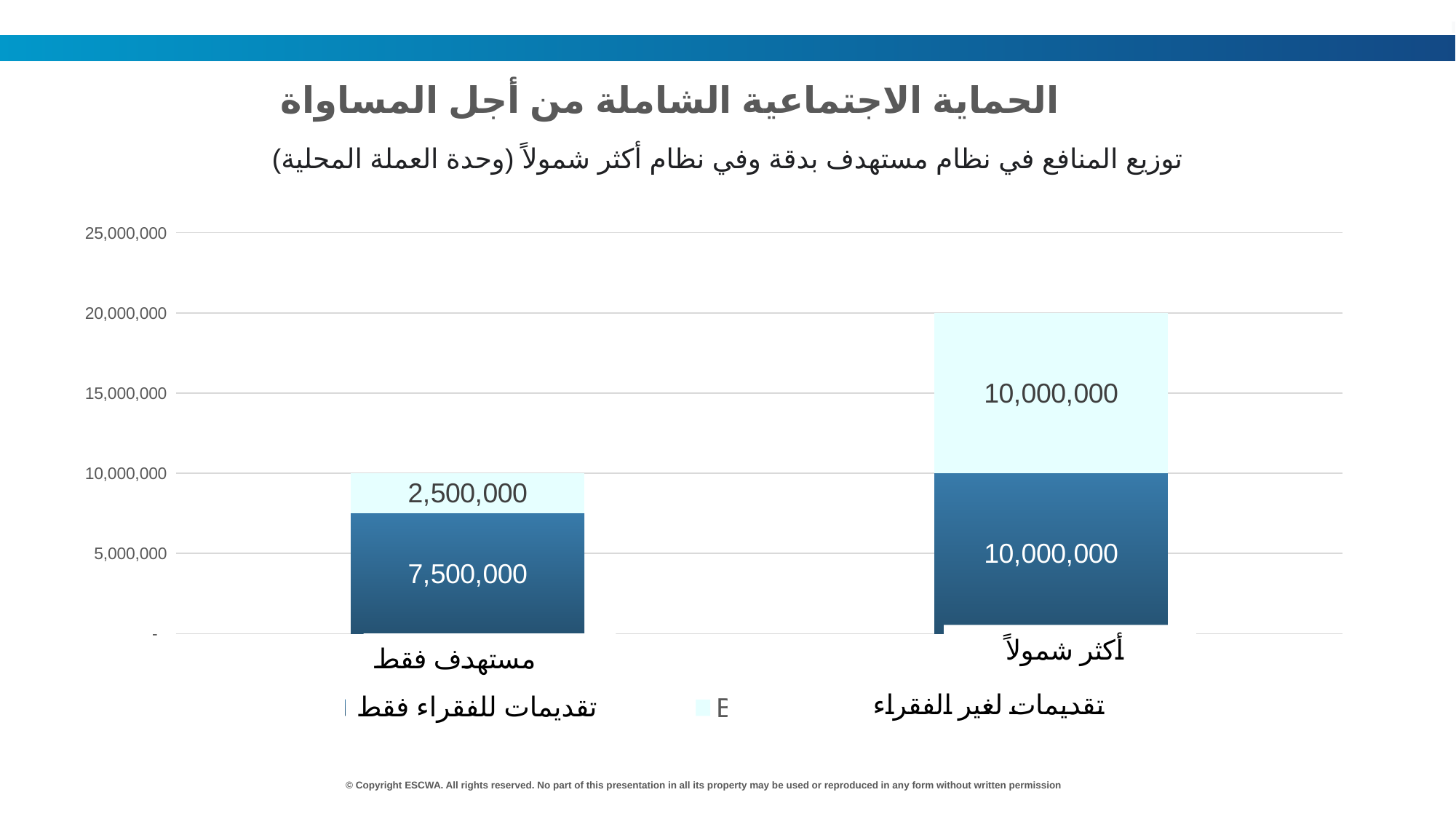
Which category has the higher total stacked bar? أكثر شمولاً What is the total of the stacked bar for مستهدف فقط? 10,000,000 What type of chart is shown on the slide? Stacked bar chart What is the total of the stacked bar for أكثر شمولاً? 20,000,000 What is the value of تقديمات للفقراء فقط for the category مستهدف فقط? 7,500,000 How many categories are shown on the x axis of the chart? 2 What is the value of تقديمات لغير الفقراء for the category أكثر شمولاً? 10,000,000 What is the difference between the تقديمات للفقراء فقط values for أكثر شمولاً and مستهدف فقط? 2,500,000 Is the value of تقديمات لغير الفقراء for مستهدف فقط greater or less than 5,000,000? less Which series is drawn in dark blue in the chart? تقديمات للفقراء فقط What is the value of تقديمات لغير الفقراء for the category مستهدف فقط? 2,500,000 What is the value of تقديمات للفقراء فقط for the category أكثر شمولاً? 10,000,000